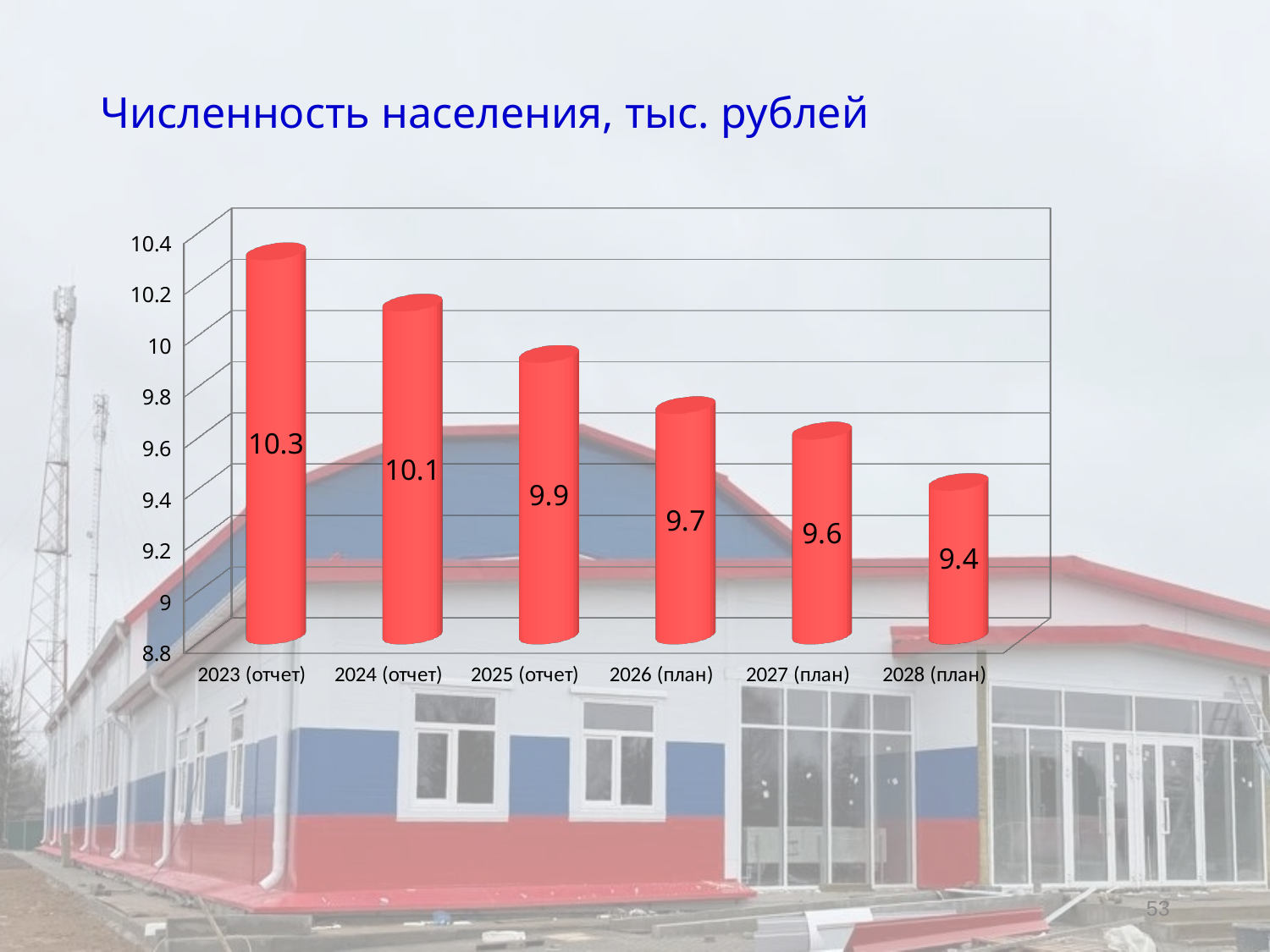
What kind of chart is shown on the slide? bar chart Which category has the highest value? 2023 (отчет) Which is larger, the value for 2024 (отчет) or the value for 2027 (план)? 2024 (отчет) Do the values rise or fall from 2023 to 2028? fall What is the value for 2023 (отчет)? 10.3 Is the value for 2025 (отчет) greater or less than 10? less Which category has the lowest value? 2028 (план) What is the value for 2028 (план)? 9.4 What is the title of the chart? Численность населения, тыс. рублей What is the value for 2026 (план)? 9.7 What is the difference between the values for 2023 (отчет) and 2028 (план)? 0.9 How many categories are shown on the x axis? 6